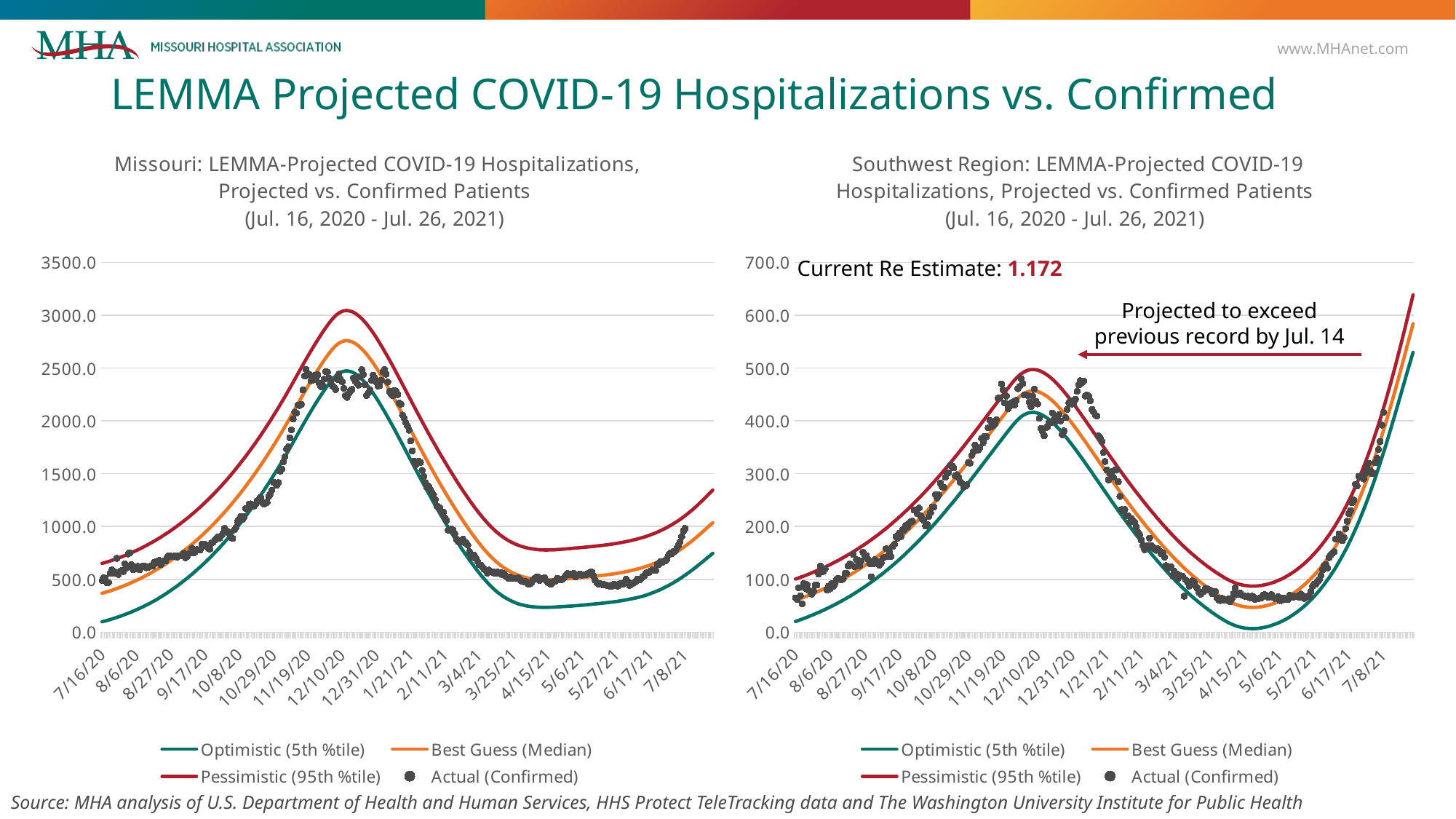
What is the Current Re Estimate shown on the Southwest Region chart? 1.172 On the Missouri chart, is the Pessimistic (95th %tile) value at 7/16/20 greater or less than 500? greater On the Southwest Region chart, is the peak value of the Best Guess (Median) line greater or less than 500? less On the Missouri chart, is the Optimistic (5th %tile) value at 7/16/20 greater or less than 500? less On the Missouri chart, which line is higher at 12/10/20: Pessimistic (95th %tile) or Optimistic (5th %tile)? Pessimistic (95th %tile) What date range do both chart titles cover? Jul. 16, 2020 - Jul. 26, 2021 How many series does the legend of the Southwest Region chart list? 4 On the Southwest Region chart, do the projected lines rise or fall between 12/10/20 and 4/15/21? Fall What kind of chart is the Missouri chart on the left? Line chart